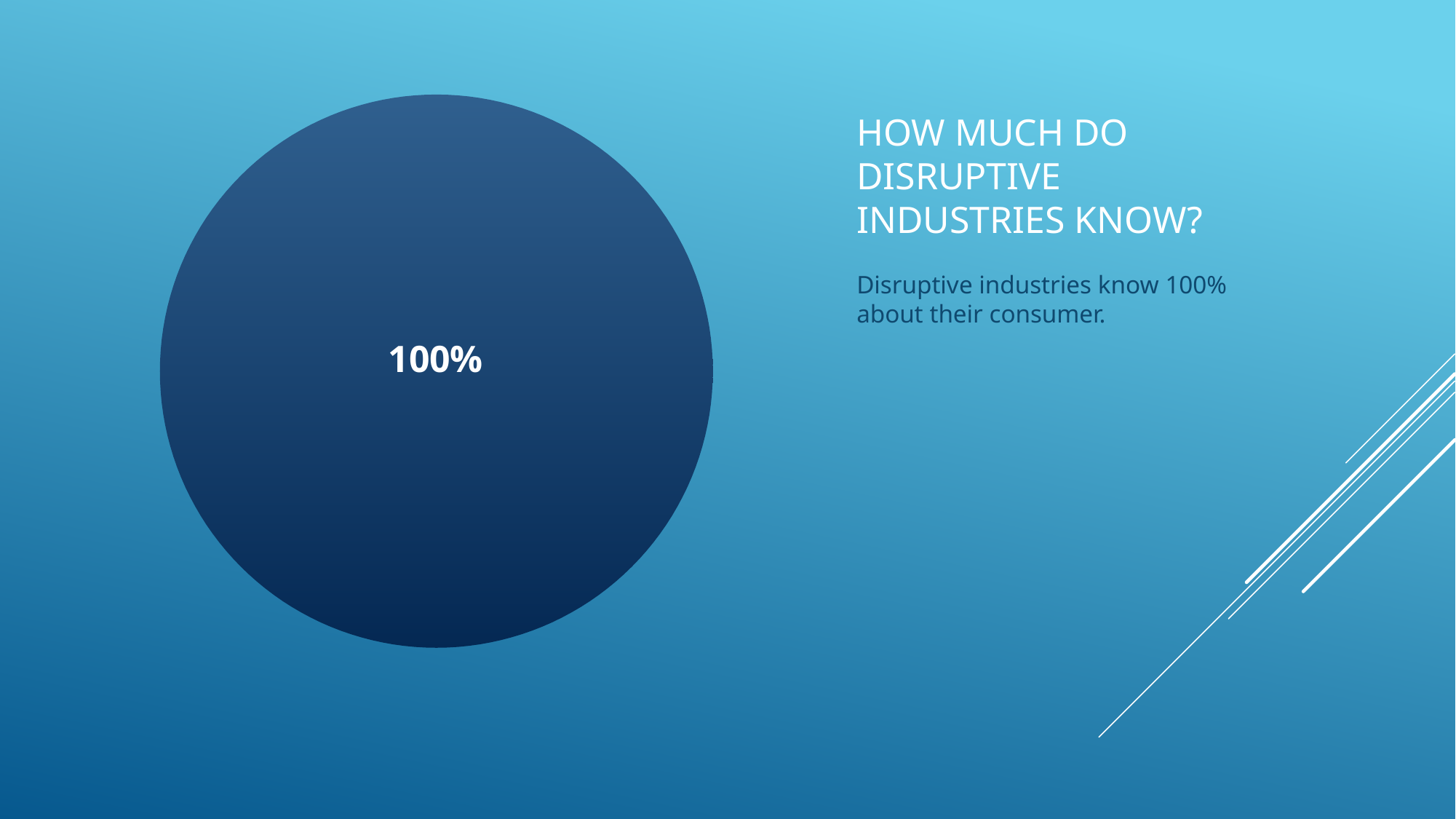
What kind of chart is shown on the slide? pie chart How many slices does the pie chart have? 1 What value is printed on the data label of the pie chart? 100% Is the value shown on the pie chart greater or less than 50%? greater What share of the pie does the single slice take up? 100% Does the pie chart show a legend? No What colour is the pie chart's slice? dark blue